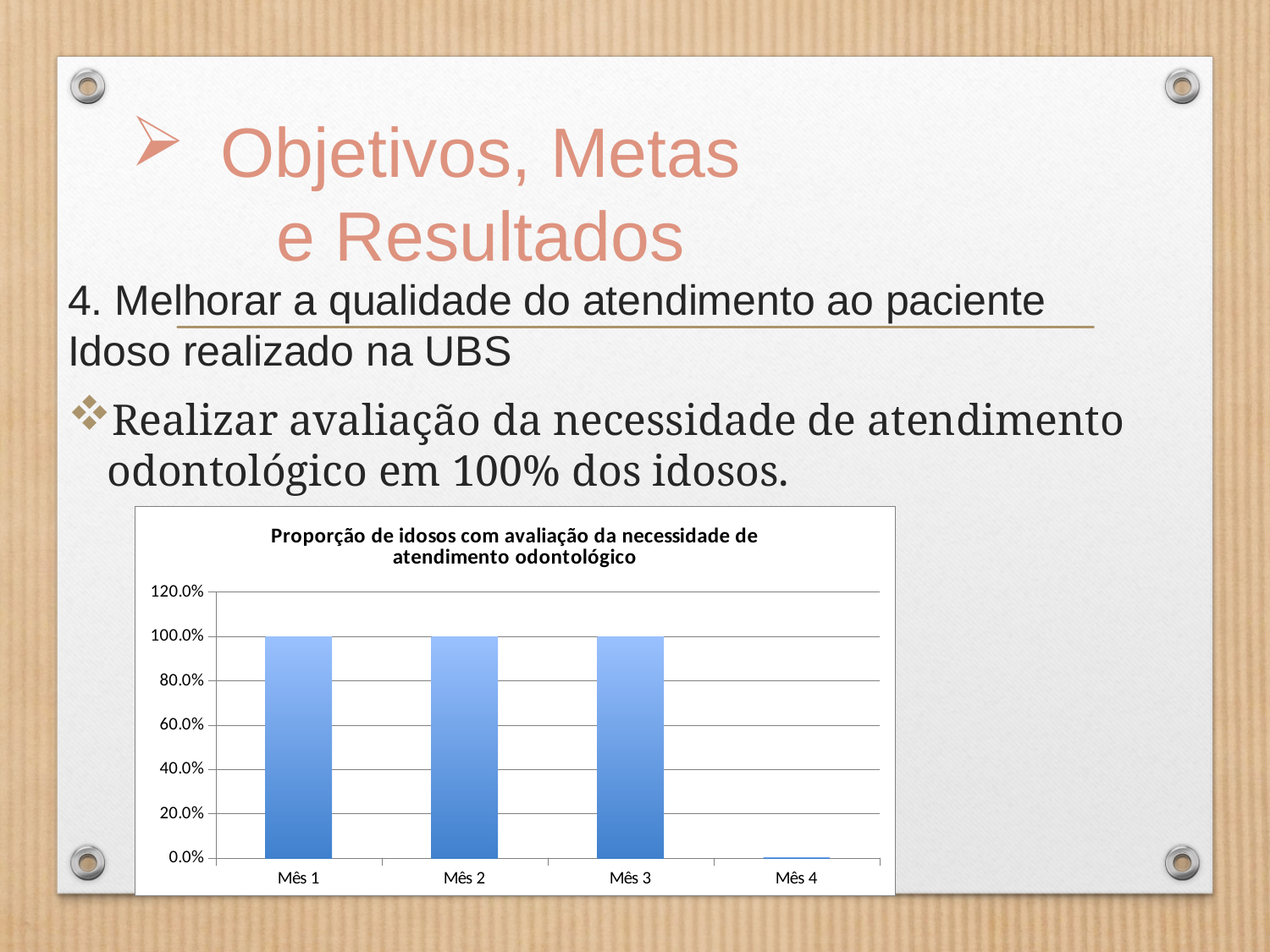
Do the values rise or fall from Mês 3 to Mês 4? fall What type of chart is shown on the slide? bar chart What colour are the bars in the chart? blue Which month has the lowest value? Mês 4 Which is larger, the value for Mês 3 or the value for Mês 4? Mês 3 Is the value for Mês 2 greater or less than 80.0%? greater What is the value for Mês 2? 100.0% What is the value for Mês 3? 100.0% What is the value for Mês 1? 100.0% How many months (categories) are shown on the x axis of the chart? 4 What is the title of the chart? Proporção de idosos com avaliação da necessidade de atendimento odontológico Is the value for Mês 4 greater or less than 20.0%? less